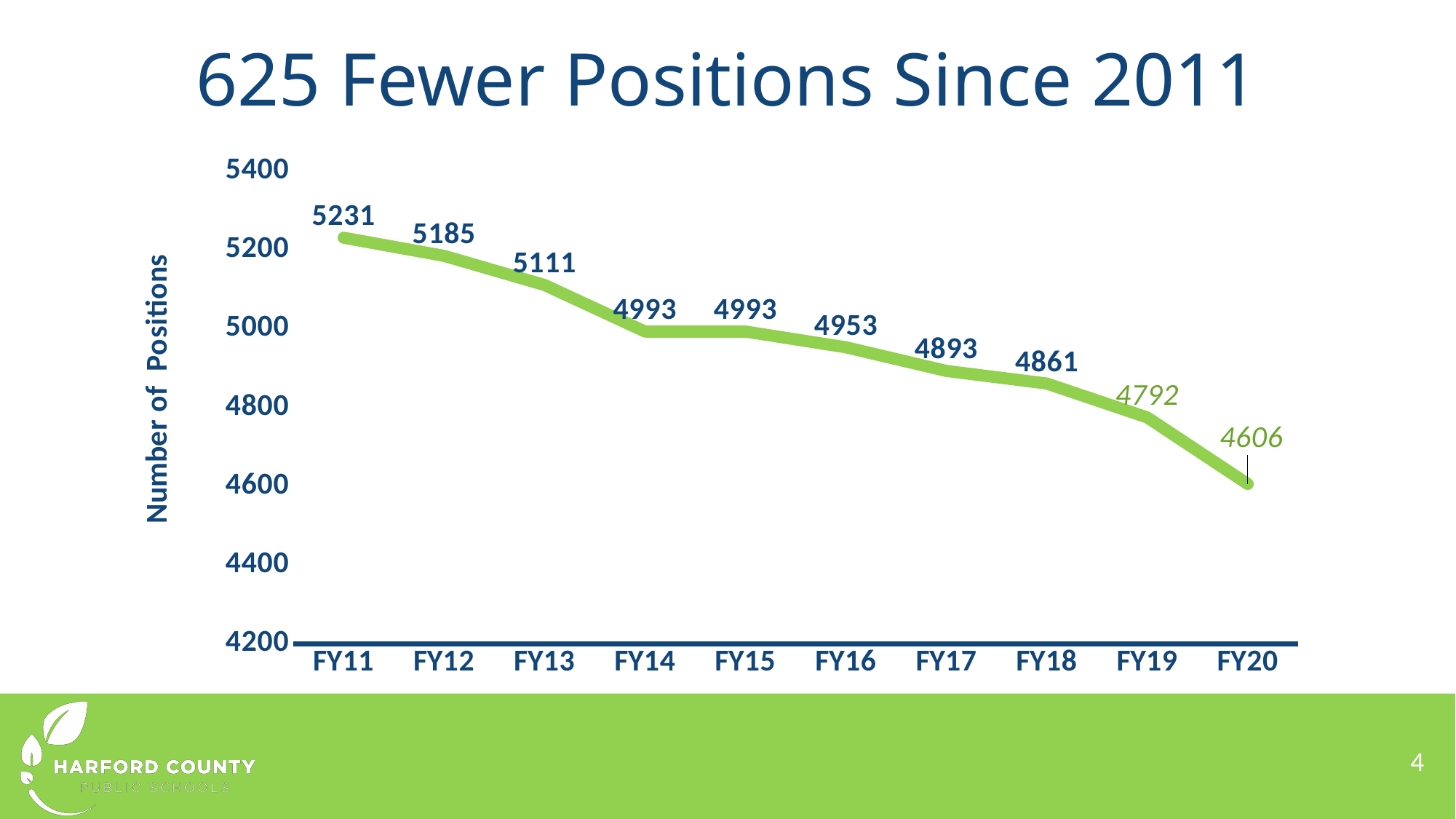
What is the number of positions in FY20? 4606 What is the number of positions in FY16? 4953 What is the title of the slide? 625 Fewer Positions Since 2011 Which has more positions, FY13 or FY17? FY13 What is the number of positions in FY11? 5231 How many fiscal years are plotted on the chart? 10 What is the difference in the number of positions between FY18 and FY19? 69 What is the difference in the number of positions between FY11 and FY20? 625 Which fiscal year has the lowest number of positions? FY20 Which fiscal year has the highest number of positions? FY11 Do the number of positions rise or fall from FY11 to FY20? Fall What kind of chart is shown on the slide? Line chart